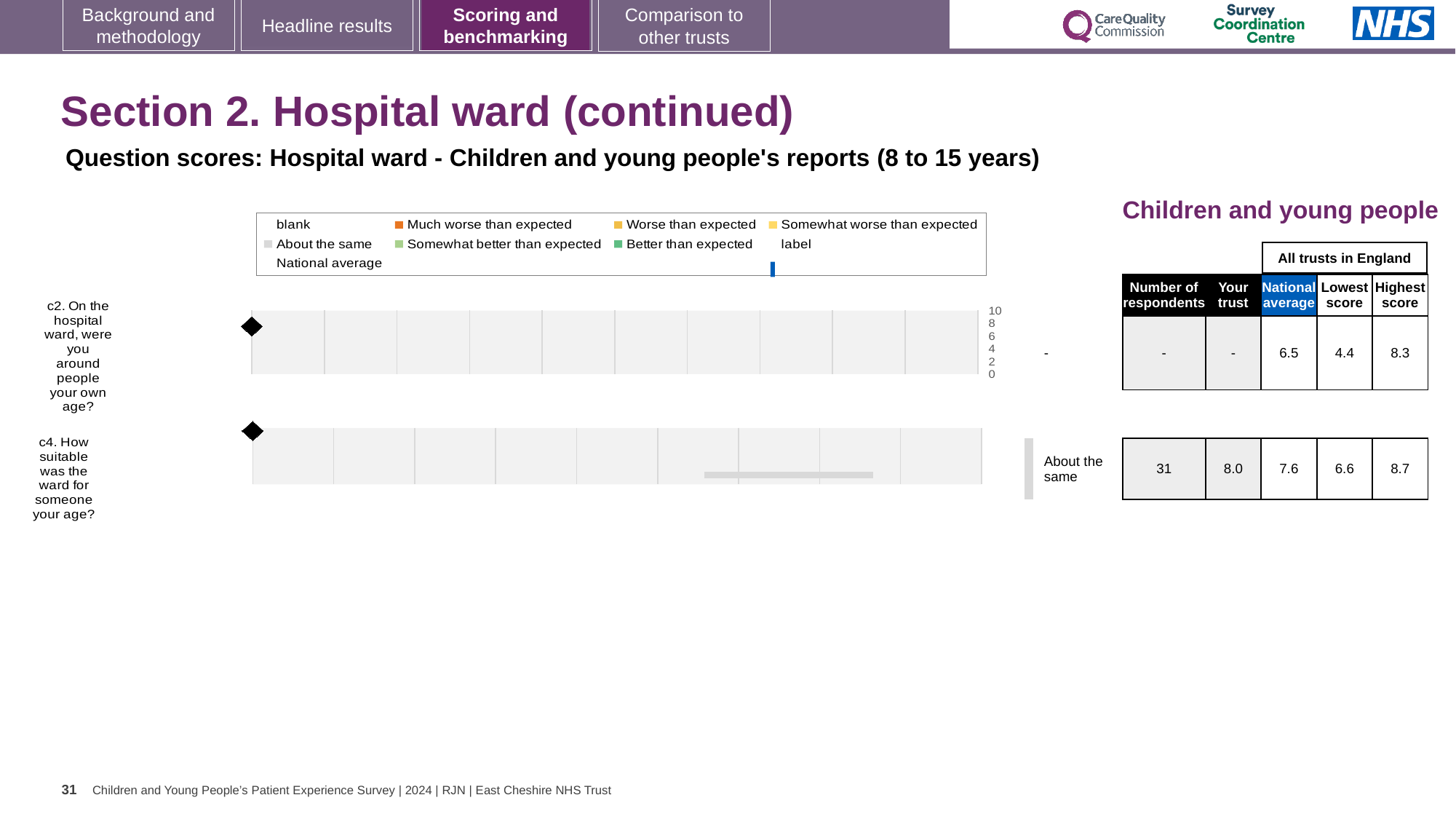
How many questions (categories) are plotted in the chart on this slide? 2 What kind of chart is used to show the question scores on this slide? bar chart How many respondents answered question c4 (How suitable was the ward for someone your age?)? 31 Which is larger for question c4: the 'Your trust' score or the national average? Your trust What is the lowest score among all trusts in England for question c4 (How suitable was the ward for someone your age?)? 6.6 What is the highest score among all trusts in England for question c2 (On the hospital ward, were you around people your own age?)? 8.3 What benchmark category is shown for question c4 (How suitable was the ward for someone your age?)? About the same What is the maximum value shown on the chart's score axis? 10 What is the 'Your trust' score for question c4 (How suitable was the ward for someone your age?)? 8.0 Which legend entry is shown with an orange marker? Much worse than expected What is the difference between the 'Your trust' score and the national average for question c4? 0.4 What is the national average score for question c4 (How suitable was the ward for someone your age?)? 7.6